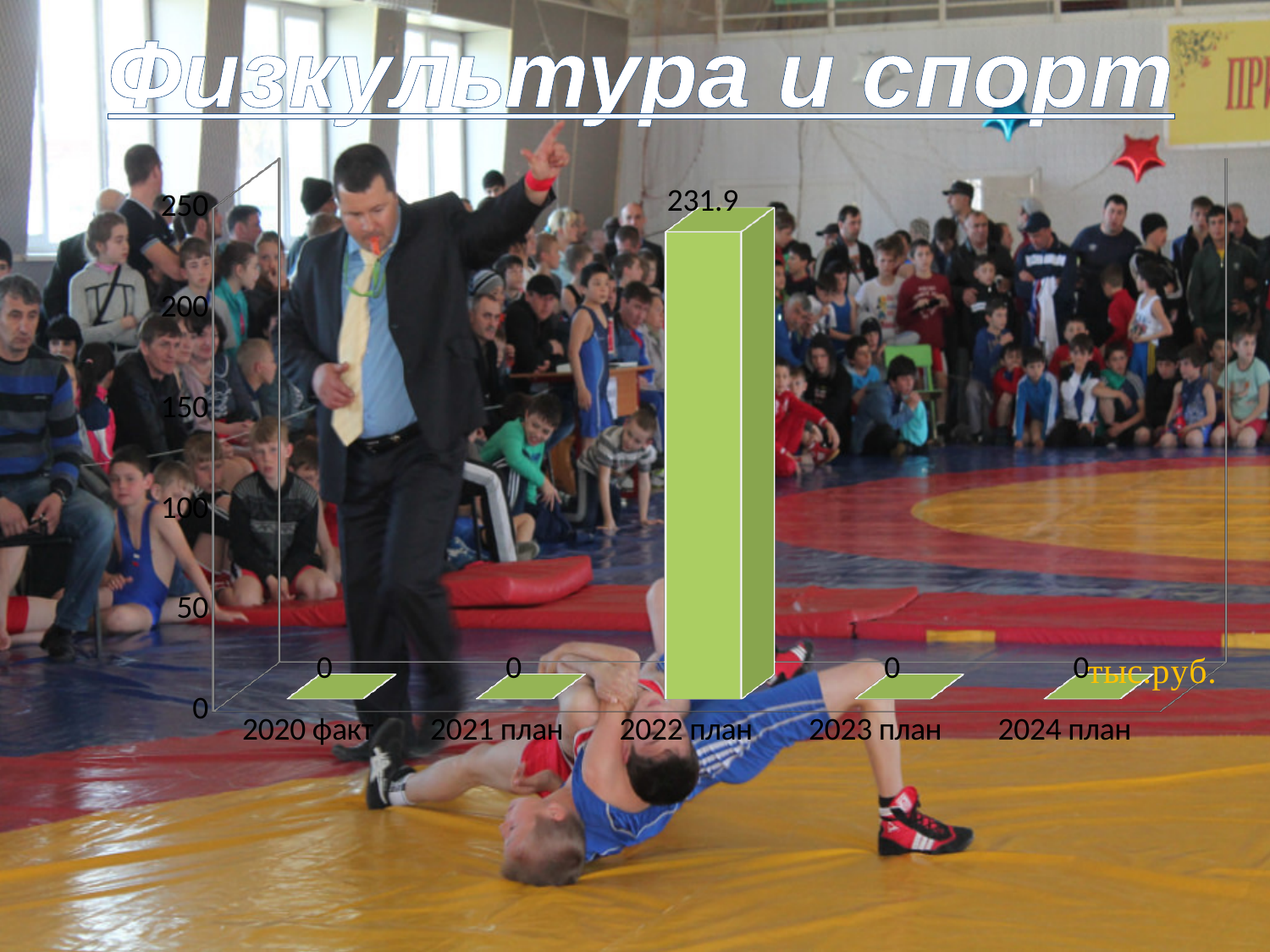
Is the value for 2022 план greater or less than 200? greater What unit is indicated next to the chart? тыс.руб. How many categories are shown on the x axis? 5 What is the value for 2022 план? 231.9 What is the difference between the values for 2022 план and 2021 план? 231.9 What is the value for 2020 факт? 0 What is the value for 2024 план? 0 What is the title of the slide? Физкультура и спорт Which category has the highest value? 2022 план What kind of chart is shown on the slide? bar chart Which is larger, the value for 2022 план or the value for 2023 план? 2022 план How many categories have a value of 0? 4